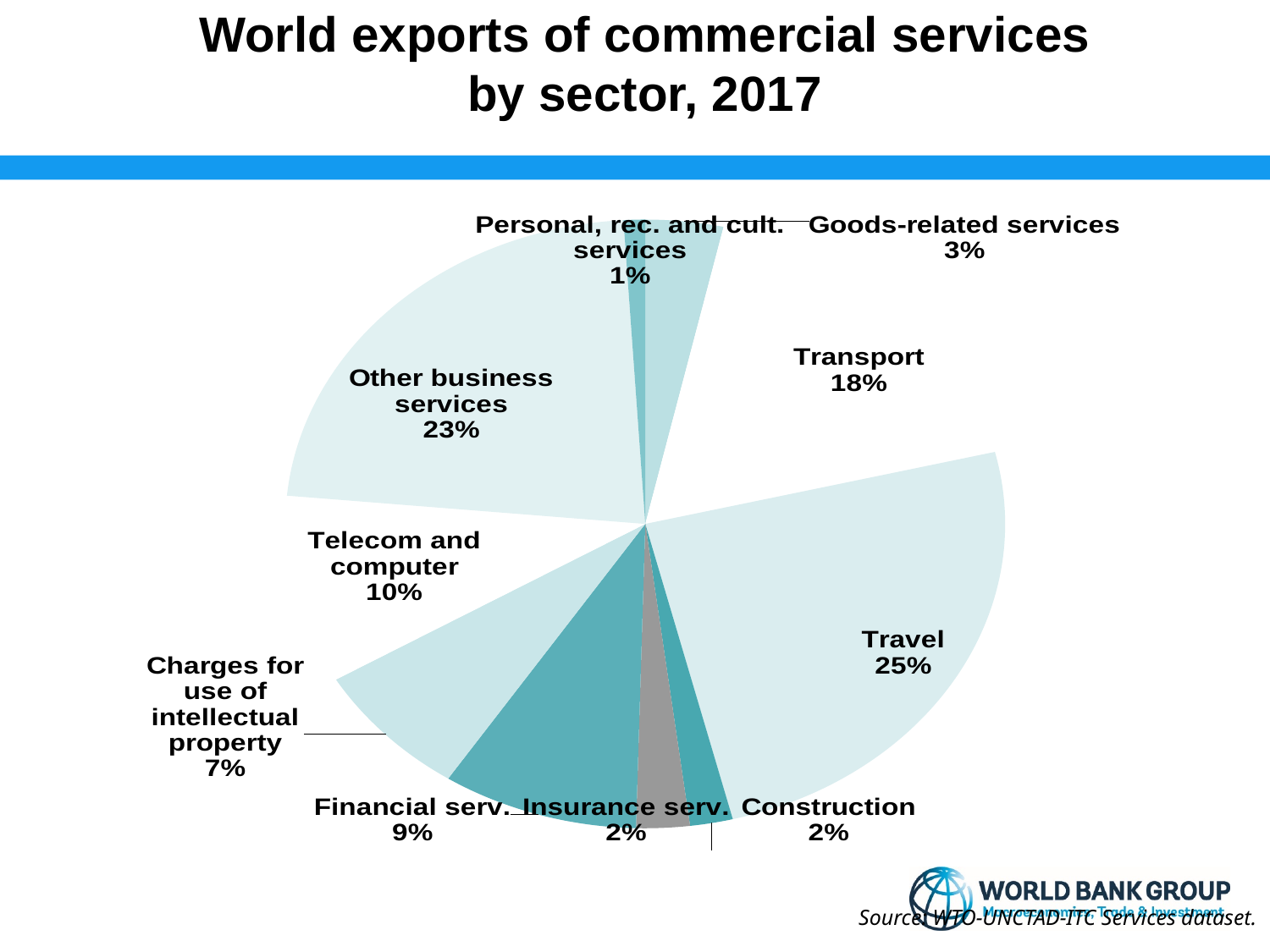
Which is larger, the share for Goods-related services or the share for Financial serv.? Financial serv. Which sector has the smallest share of the pie? Personal, rec. and cult. services How many sectors are shown in the pie chart? 10 What is the difference in percentage points between Travel and Other business services? 2 Which sector has the largest share of the pie? Travel What is the difference in percentage points between Transport and Financial serv.? 9 What is the title of the chart? World exports of commercial services by sector, 2017 What percentage is shown for Telecom and computer? 10% What is the value for Charges for use of intellectual property? 7% What kind of chart is shown on the slide? pie chart What share of world exports of commercial services does Travel account for? 25% What is the value shown for Transport? 18%